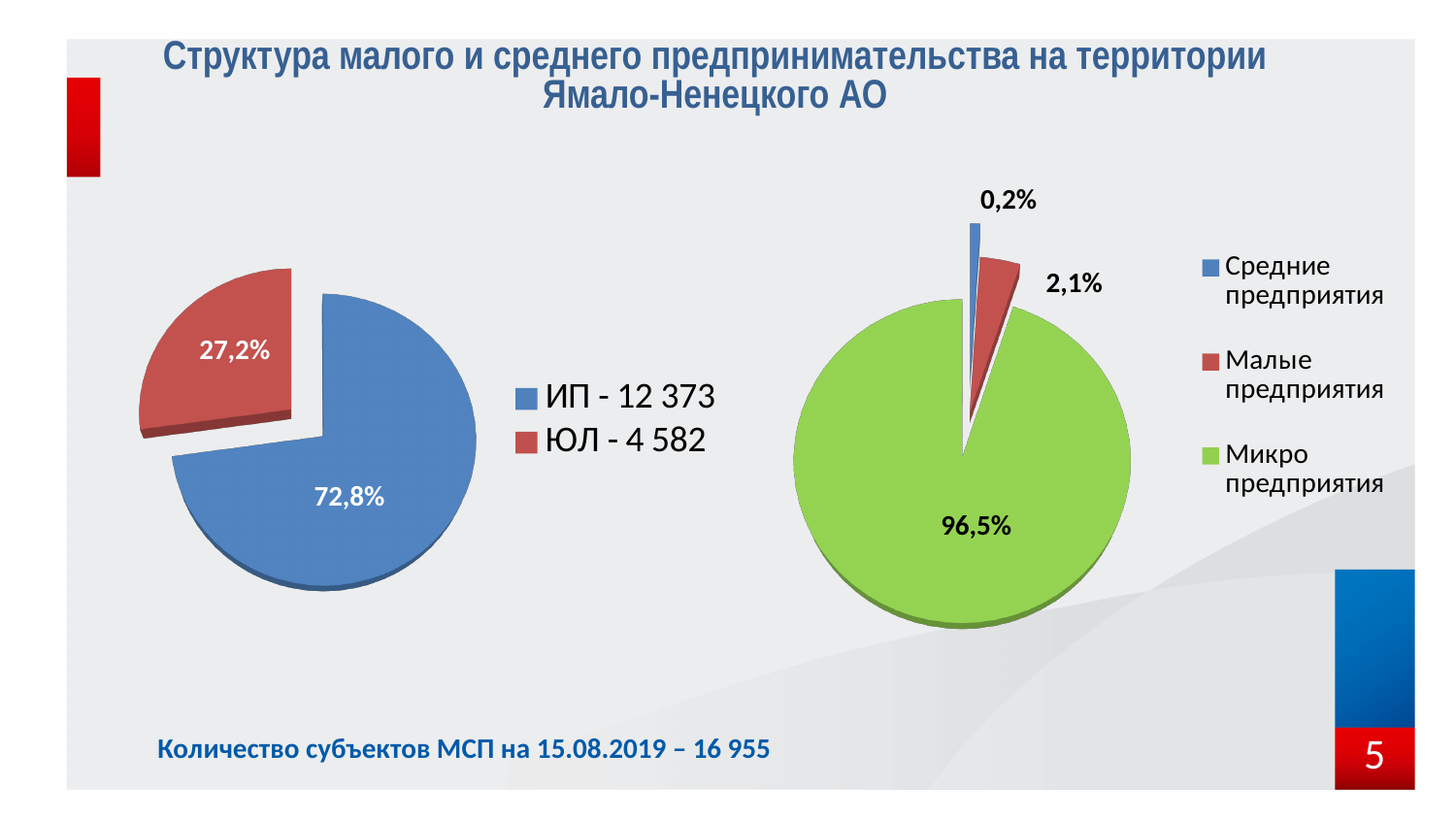
In the right pie chart, what share is shown for Средние предприятия? 0,2% In the left pie chart, what share is shown for ЮЛ? 27,2% In the right pie chart, what colour is the slice for Микро предприятия? green In the left pie chart, what share is shown for ИП? 72,8% What kind of chart is the left chart on the slide? pie chart In the left pie chart, which category has the larger share, ИП or ЮЛ? ИП In the left pie chart, what is the difference in percentage points between the ИП share and the ЮЛ share? 45,6 How many entries does the legend of the left pie chart list? 2 In the right pie chart, what share is shown for Малые предприятия? 2,1% In the right pie chart, which category has the smallest share? Средние предприятия How many slices does the right pie chart have? 3 In the right pie chart, what share is shown for Микро предприятия? 96,5%